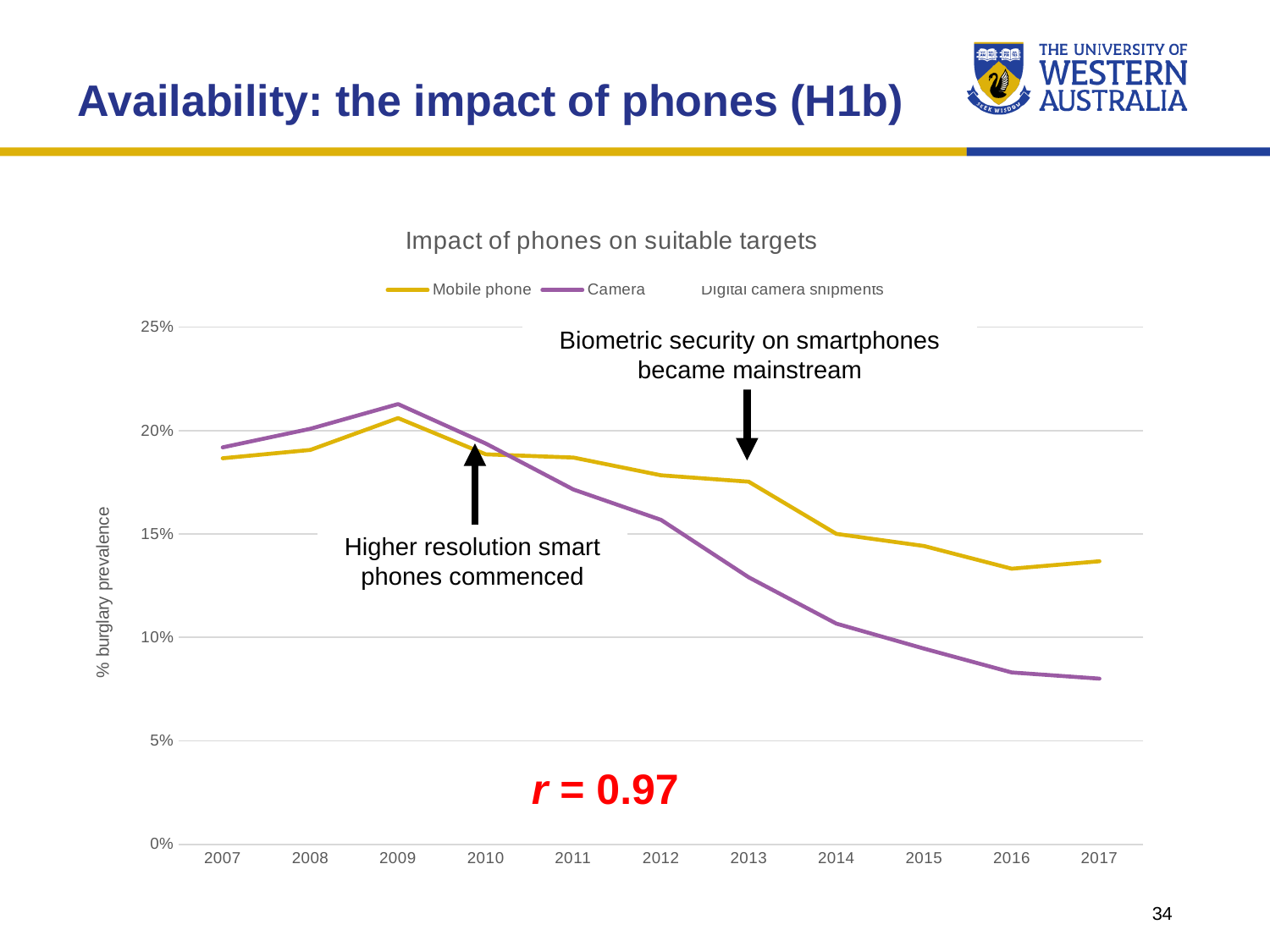
What is the title of the chart? Impact of phones on suitable targets In which year does the Mobile phone series reach its highest value? 2009 Is the Camera value for 2009 greater or less than 20%? greater What kind of chart is shown on the slide? Line chart In which year does the Camera series reach its highest value? 2009 Does the Camera series rise or fall overall from 2009 to 2017? Fall In 2017, which series has the higher value, Mobile phone or Camera? Mobile phone How many series does the chart legend list? 3 Is the Mobile phone value for 2017 greater or less than 15%? less In which year does the Camera series reach its lowest value? 2017 How many years are shown on the x axis of the chart? 11 Is the Camera value for 2017 greater or less than 10%? less